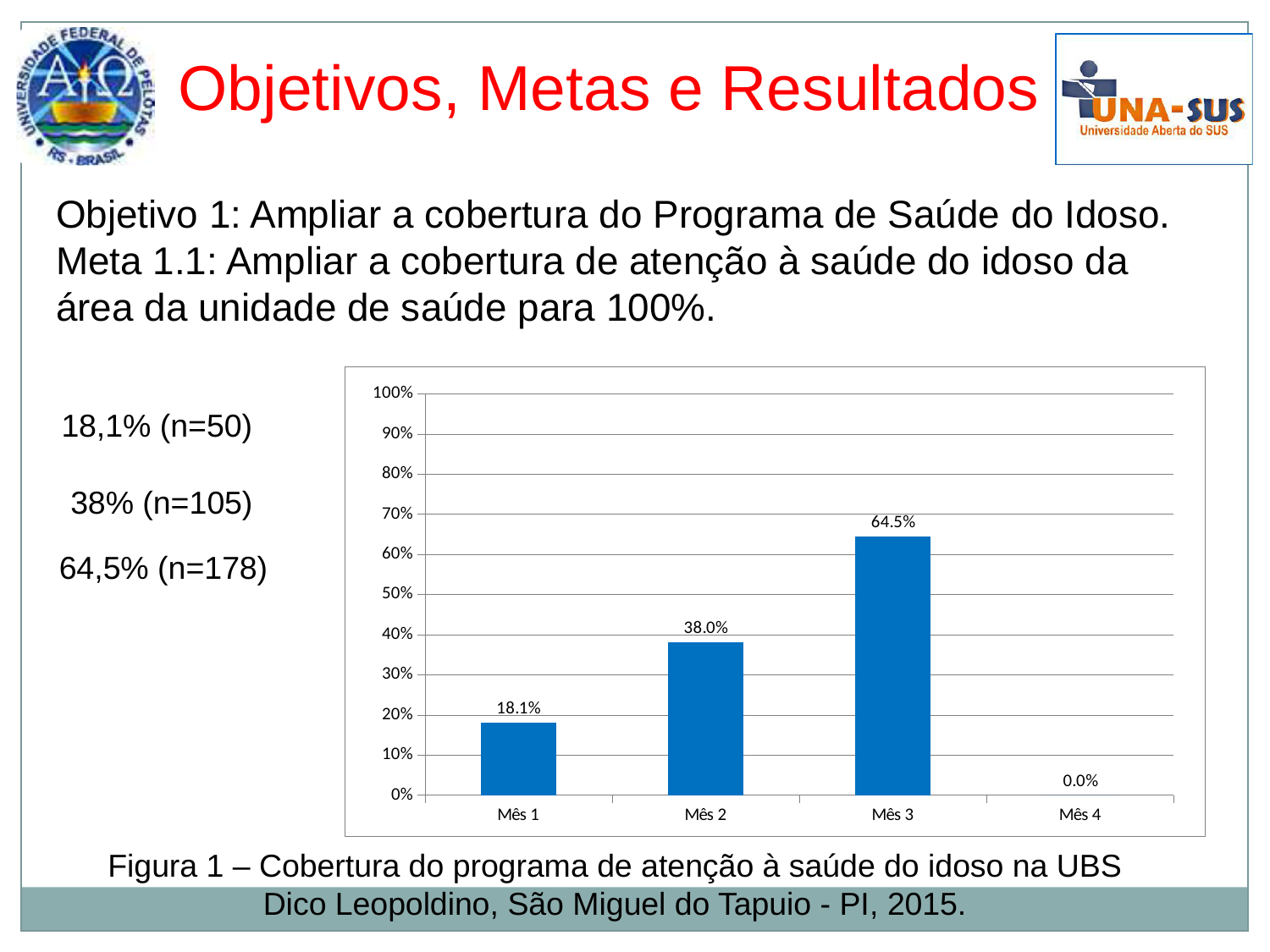
What kind of chart is shown on the slide? Bar chart What is the difference between the values for Mês 3 and Mês 2? 26.5% How many months are shown on the x axis? 4 Which month has the highest value? Mês 3 What is the difference between the values for Mês 2 and Mês 1? 19.9% What is the value for Mês 2? 38.0% What is the value for Mês 1? 18.1% Which is larger, the value for Mês 1 or the value for Mês 2? Mês 2 What is the value for Mês 3? 64.5% What is the value for Mês 4? 0.0% Do the values rise or fall from Mês 1 to Mês 3? Rise Which month has the lowest value? Mês 4